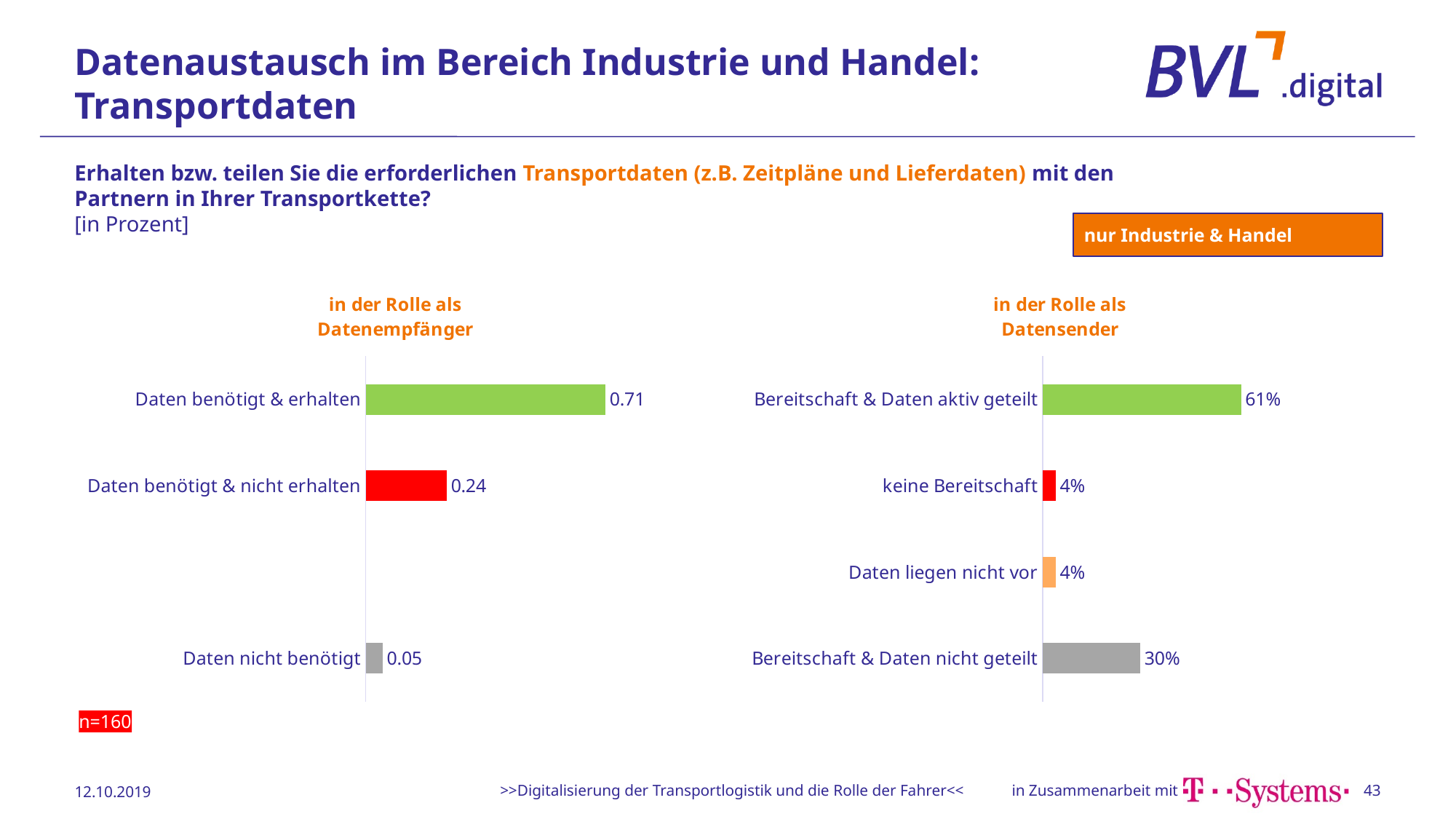
In the chart 'in der Rolle als Datensender', which category has the highest value? Bereitschaft & Daten aktiv geteilt In the chart 'in der Rolle als Datenempfänger', what is the difference between 'Daten benötigt & erhalten' and 'Daten benötigt & nicht erhalten'? 0.47 In the chart 'in der Rolle als Datensender', what is the difference between 'Bereitschaft & Daten aktiv geteilt' and 'Bereitschaft & Daten nicht geteilt'? 31% How many categories are shown in the chart 'in der Rolle als Datensender'? 4 How many categories are shown in the chart 'in der Rolle als Datenempfänger'? 3 In the chart 'in der Rolle als Datensender', what is the value for 'keine Bereitschaft'? 4% In the chart 'in der Rolle als Datenempfänger', what is the value for 'Daten benötigt & erhalten'? 0.71 In the chart 'in der Rolle als Datensender', what is the value for 'Bereitschaft & Daten nicht geteilt'? 30% In the chart 'in der Rolle als Datensender', what is the value for 'Bereitschaft & Daten aktiv geteilt'? 61% In the chart 'in der Rolle als Datenempfänger', what is the value for 'Daten benötigt & nicht erhalten'? 0.24 In the chart 'in der Rolle als Datenempfänger', which category has the lowest value? Daten nicht benötigt What type of chart is used for 'in der Rolle als Datensender'? Bar chart